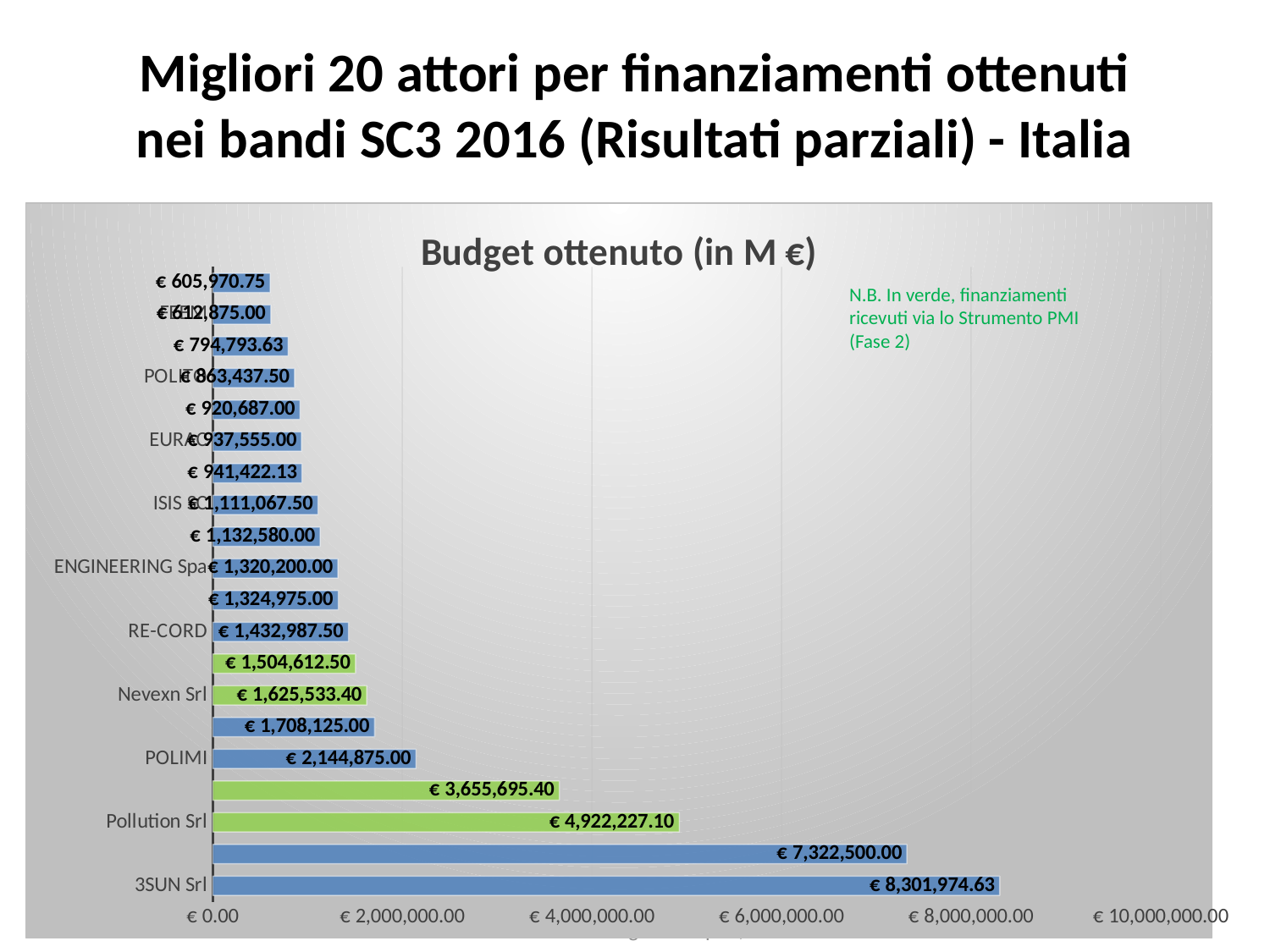
What is the value for POLIMI? € 2,144,875.00 Which is larger, the value for POLIMI or the value for Nevexn Srl? POLIMI What is the value for Nevexn Srl? € 1,625,533.40 How many bars are plotted in the chart? 20 What is the value for RE-CORD? € 1,432,987.50 Which actor has the highest budget obtained? 3SUN Srl What is the value for 3SUN Srl? € 8,301,974.63 What is the value for ENGINEERING Spa? € 1,320,200.00 What kind of chart is shown on the slide? bar chart What is the value for Pollution Srl? € 4,922,227.10 What is the difference between the values for 3SUN Srl and Pollution Srl? € 3,379,747.53 Is the value for POLIMI greater or less than € 2,000,000.00? greater